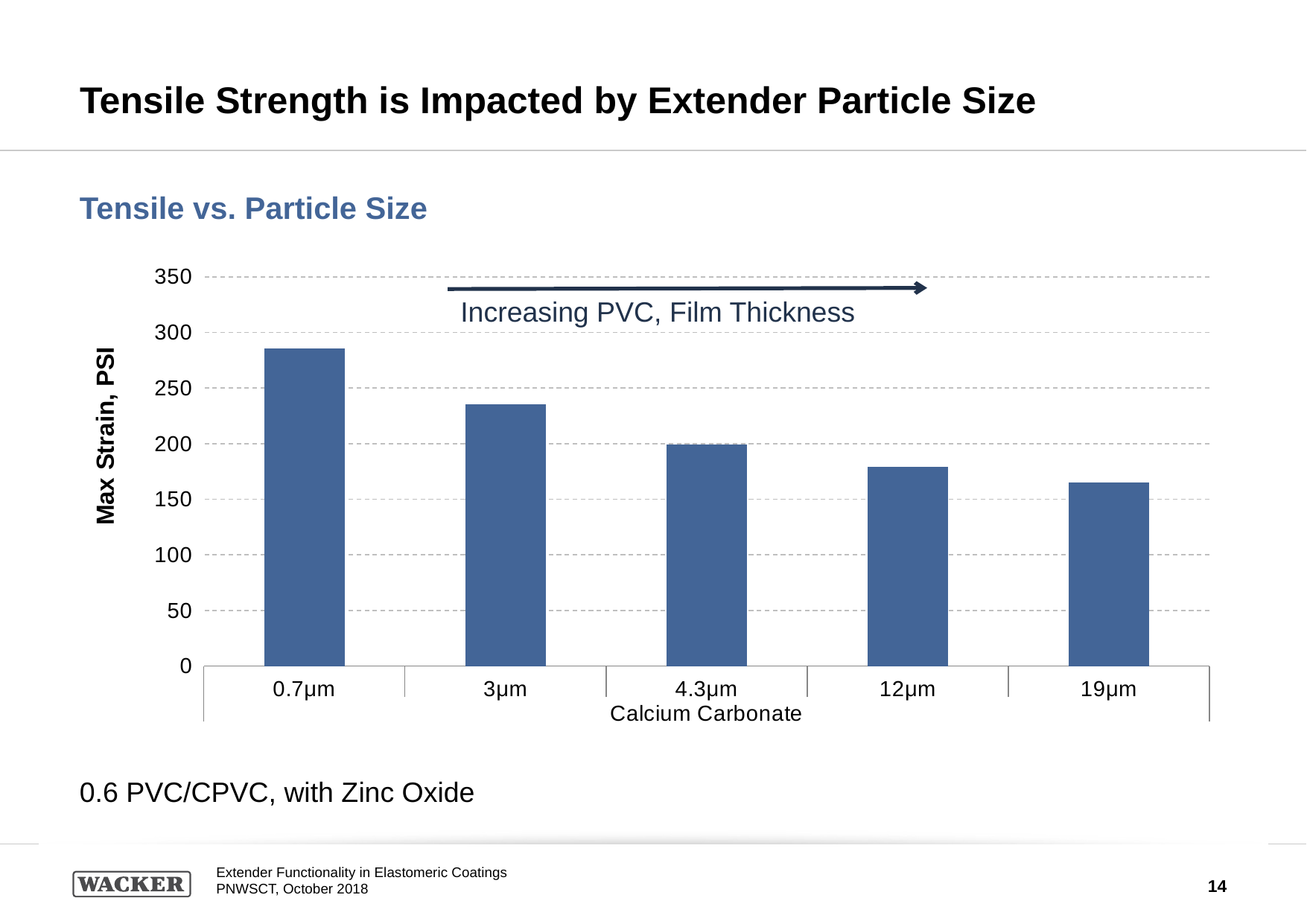
Is the Max Strain for 12µm greater or less than 200? less Do the Max Strain values rise or fall as particle size increases along the x axis? fall What kind of chart is shown on the slide? bar chart Which particle size has the lowest Max Strain? 19µm What is the label of the y axis? Max Strain, PSI Which has a larger Max Strain, 3µm or 12µm? 3µm What is the title of the chart? Tensile vs. Particle Size Is the Max Strain for 19µm greater or less than 150? greater Is the Max Strain for 0.7µm greater or less than 250? greater How many particle-size categories are plotted on the x axis? 5 Which particle size has the highest Max Strain? 0.7µm